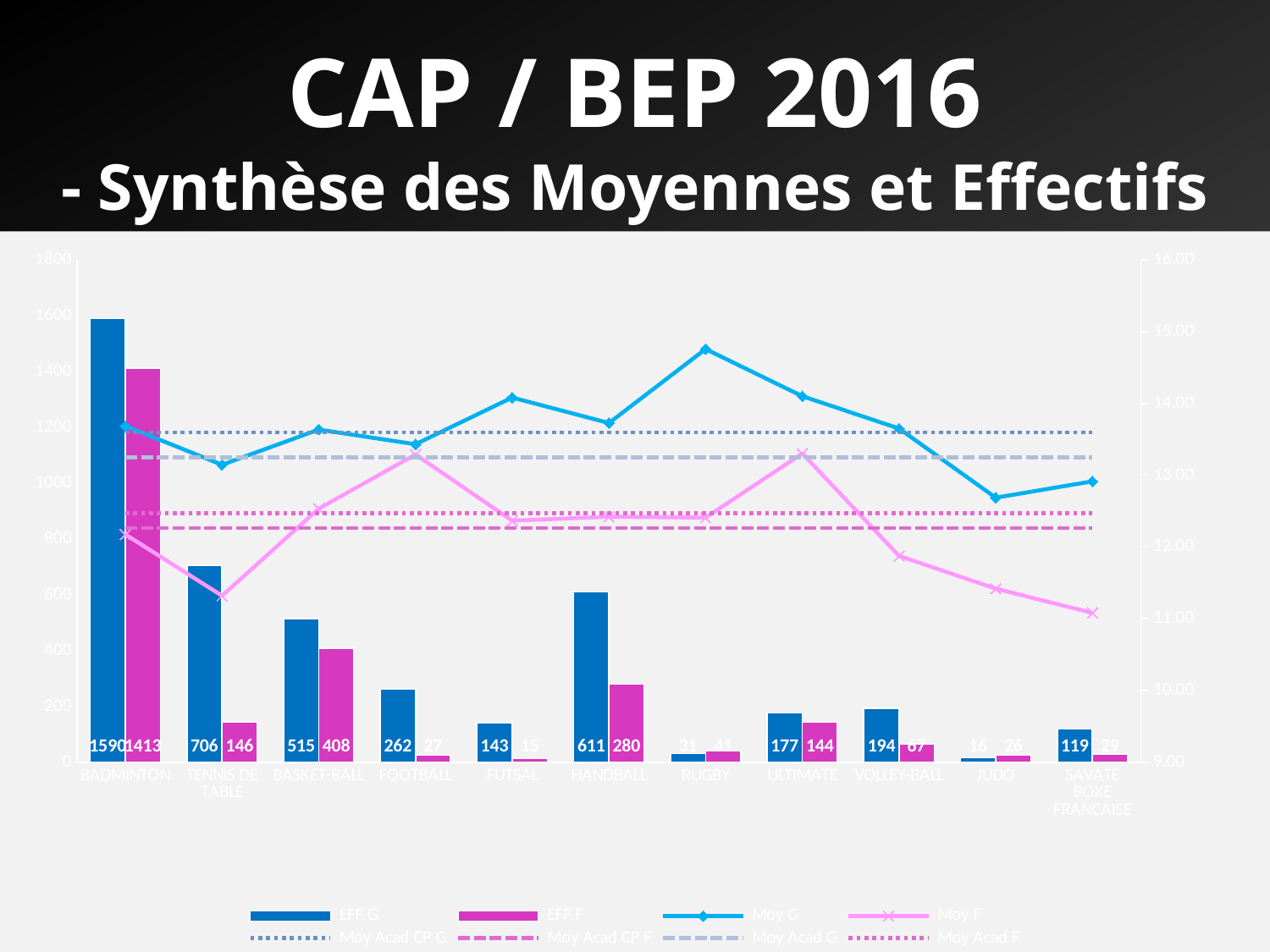
Is the Moy G value for RUGBY greater or less than 14.00 on the right axis? greater How many series does the legend list? 8 What is the EFF F value for HANDBALL? 280 For RUGBY, which is larger, EFF G or EFF F? EFF F What is the combined EFF G and EFF F total for BADMINTON? 3003 Which category has the lowest EFF G value? JUDO What is the EFF G value for BADMINTON? 1590 Which category has the highest EFF G value? BADMINTON What is the difference between the EFF G and EFF F values for BASKET-BALL? 107 Which category has the highest point on the Moy G line? RUGBY How many sport categories are shown on the x axis? 11 Is the Moy F value for TENNIS DE TABLE greater or less than 12.00 on the right axis? less